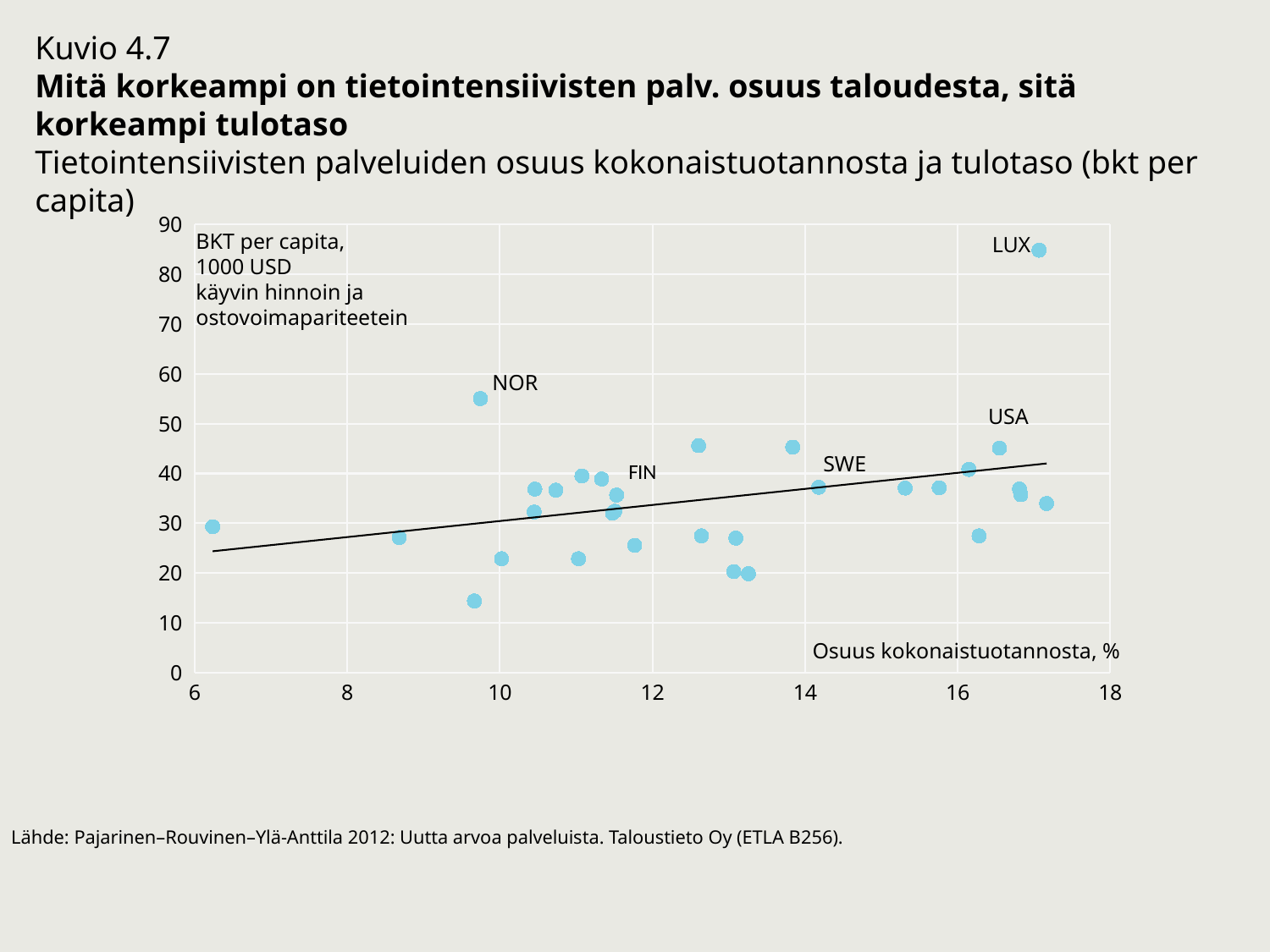
Is the share of total output (x axis) for NOR greater or less than 12? less Is the BKT per capita value for NOR greater or less than 50? greater Is the share of total output (x axis) for LUX greater or less than 16? greater Which has a higher BKT per capita, LUX or NOR? LUX Which has a higher BKT per capita, NOR or USA? NOR Which labelled country has the highest BKT per capita in the chart? LUX What is the label of the x axis? Osuus kokonaistuotannosta, % What kind of chart is shown on the slide? scatter chart Does the fitted trend line rise or fall as the share of total output increases? rises